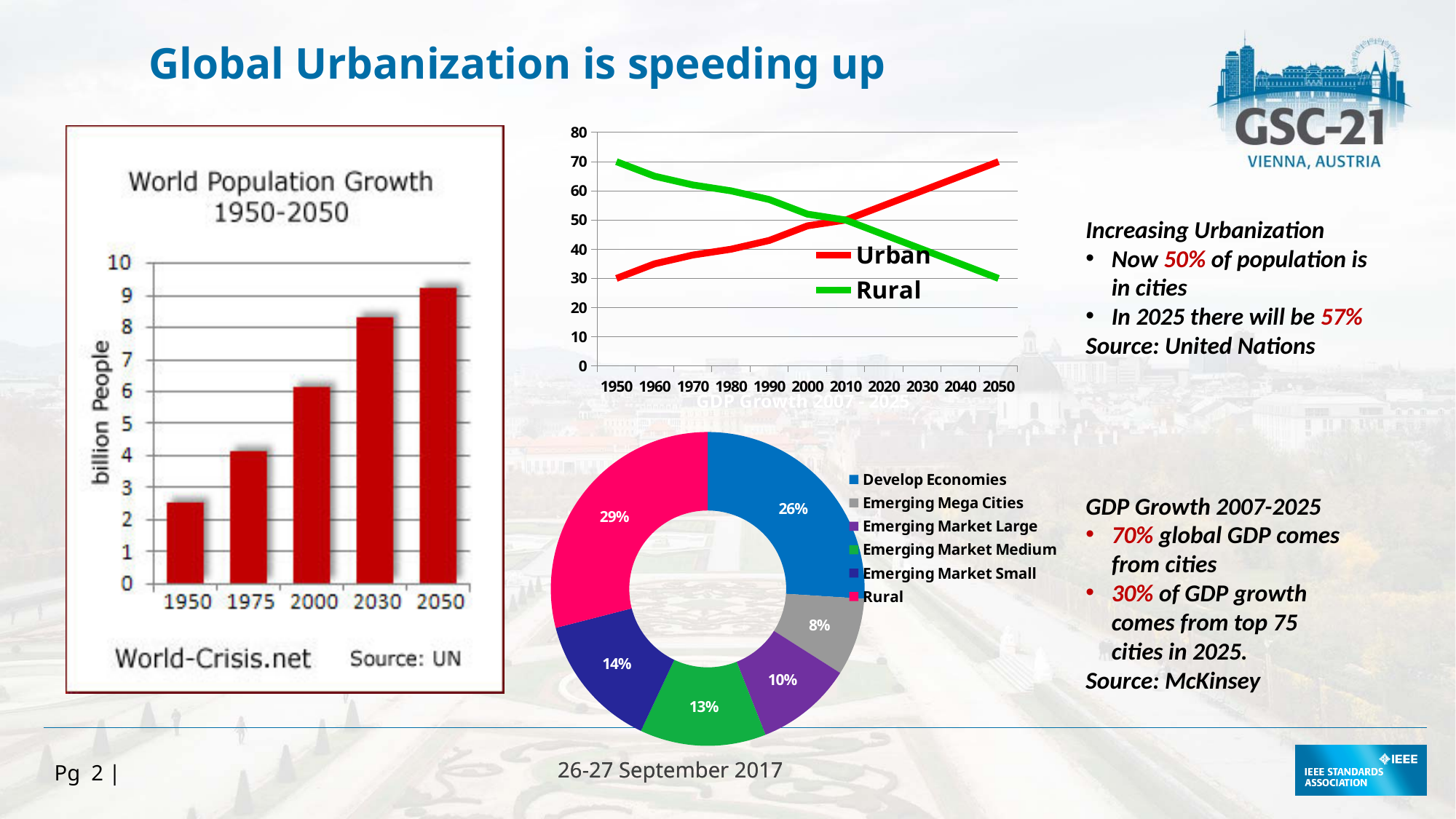
In the World Population Growth 1950-2050 chart, do the values rise or fall from 1950 to 2050? rise In the World Population Growth 1950-2050 chart, is the value for 2050 greater or less than 8 billion people? greater In the donut chart, what share is labelled for Develop Economies? 26% In the donut chart, which category has the largest share? Rural How many categories does the donut chart's legend list? 6 How many bars are in the World Population Growth 1950-2050 chart? 5 What kind of chart is the World Population Growth 1950-2050 chart? bar chart In the donut chart, what share is labelled for Rural? 29% In the donut chart, what is the difference between the Rural share and the Develop Economies share? 3% In the donut chart, which category has the smallest share? Emerging Mega Cities How many series does the legend of the Urban/Rural line chart list? 2 In the Urban/Rural line chart, does the Rural line rise or fall from 1950 to 2050? fall